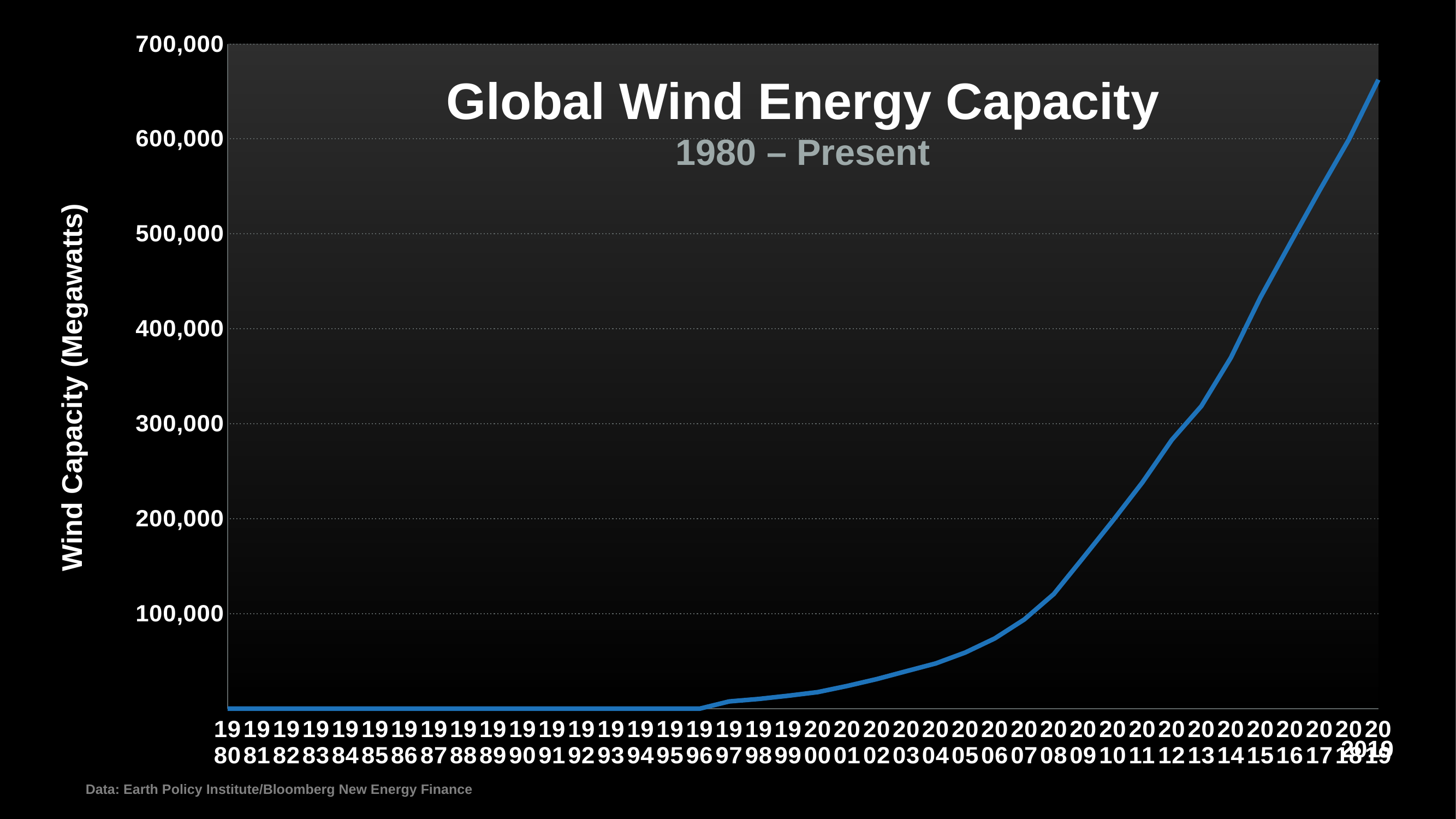
Is the wind capacity value for 2005 greater or less than 100,000? less Which year has the highest wind capacity on the chart? 2019 Which year has the larger wind capacity, 2005 or 2015? 2015 Which year has the larger wind capacity, 2010 or 2019? 2019 What kind of chart is shown on the slide? line chart Is the wind capacity value for 2000 greater or less than 100,000? less What is the label on the vertical axis of the chart? Wind Capacity (Megawatts) Is the wind capacity value for 2019 greater or less than 600,000? greater What is the title of the chart? Global Wind Energy Capacity Does wind capacity rise or fall from 1980 to 2019 along the x axis? rise